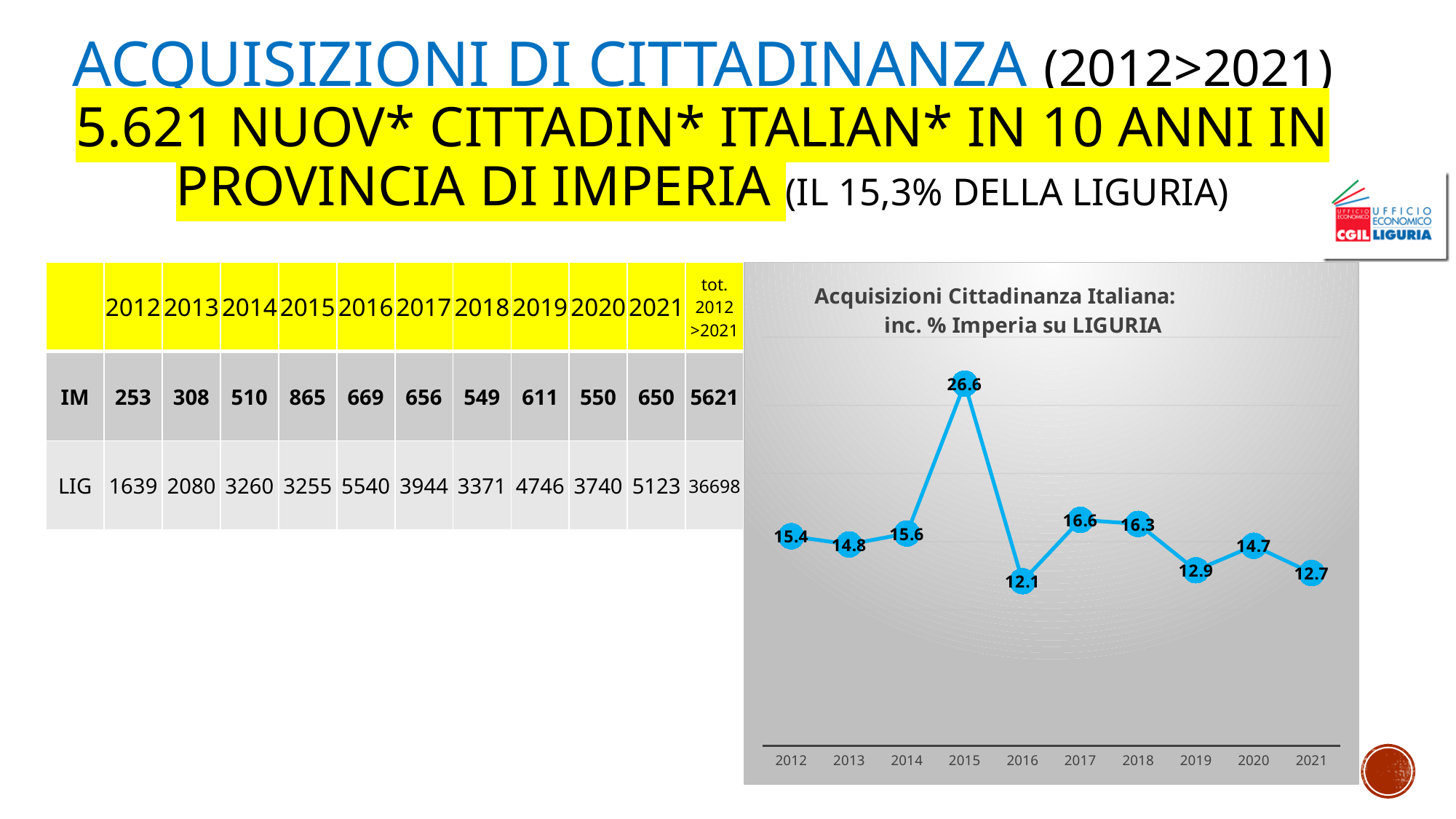
What type of chart is shown on the slide? line chart What is the difference between the values for 2015 and 2016? 14.5 What is the title of the chart? Acquisizioni Cittadinanza Italiana: inc. % Imperia su LIGURIA What is the value for 2021 in the chart? 12.7 Which year has the highest value in the chart? 2015 Does the value rise or fall from 2020 to 2021? fall What is the value for 2012 in the chart? 15.4 How many years are plotted on the x axis of the chart? 10 What is the value for 2015 in the chart? 26.6 Which year has the lowest value in the chart? 2016 What is the value for 2016 in the chart? 12.1 Which is larger, the value for 2017 or the value for 2018? 2017